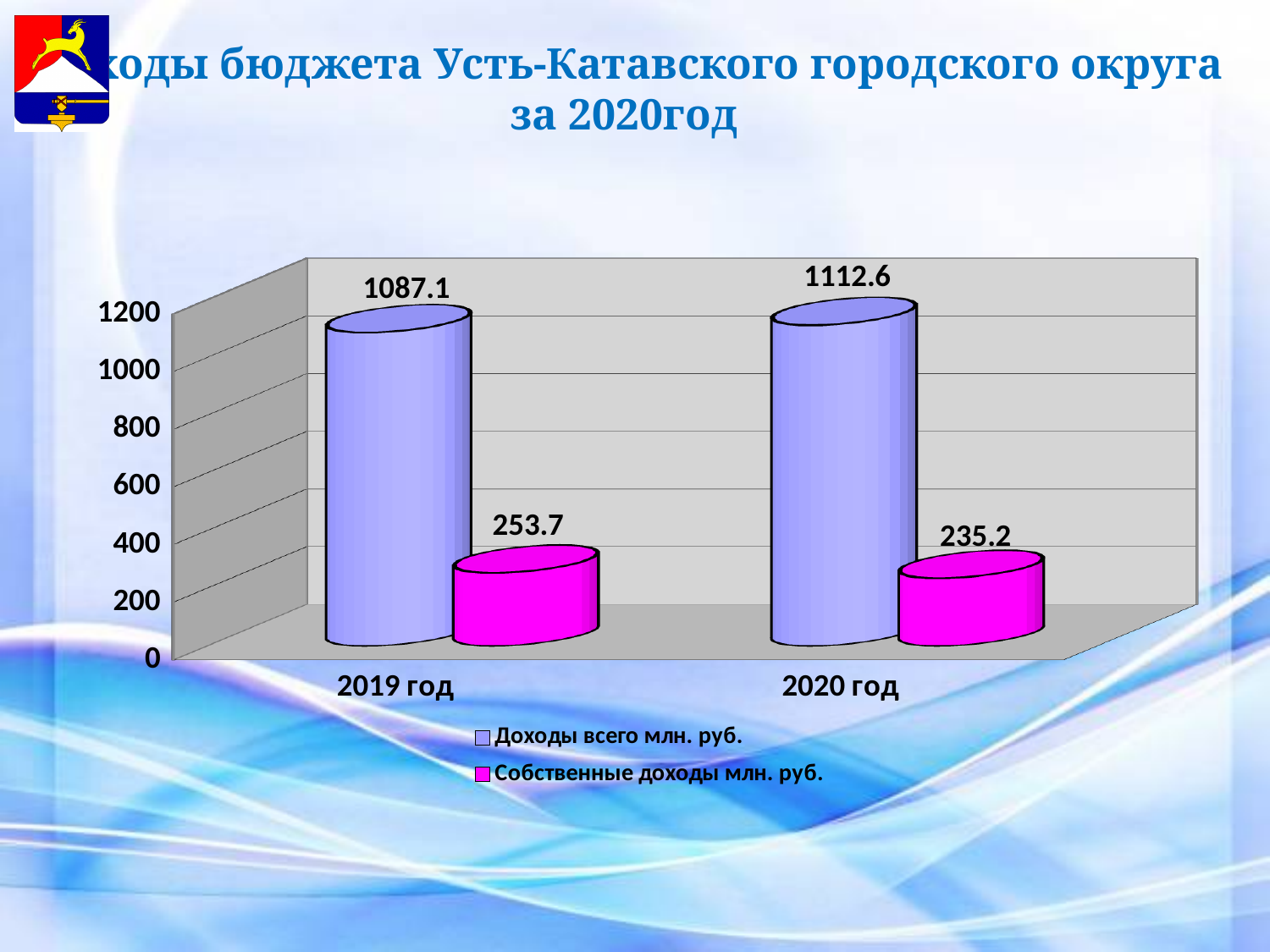
What is the difference between "Собственные доходы млн. руб." in 2019 год and in 2020 год? 18.5 Is "Собственные доходы млн. руб." for 2019 год greater or less than "Собственные доходы млн. руб." for 2020 год? greater What is the difference between "Доходы всего млн. руб." in 2020 год and in 2019 год? 25.5 What is the value of "Собственные доходы млн. руб." for 2019 год? 253.7 What is the value of "Собственные доходы млн. руб." for 2020 год? 235.2 How many categories are shown on the x axis? 2 What is the value of "Доходы всего млн. руб." for 2020 год? 1112.6 What kind of chart is shown on the slide? bar chart Which year has the lower value for "Собственные доходы млн. руб."? 2020 год How many series does the legend list? 2 Which year has the higher value for "Доходы всего млн. руб."? 2020 год What is the value of "Доходы всего млн. руб." for 2019 год? 1087.1